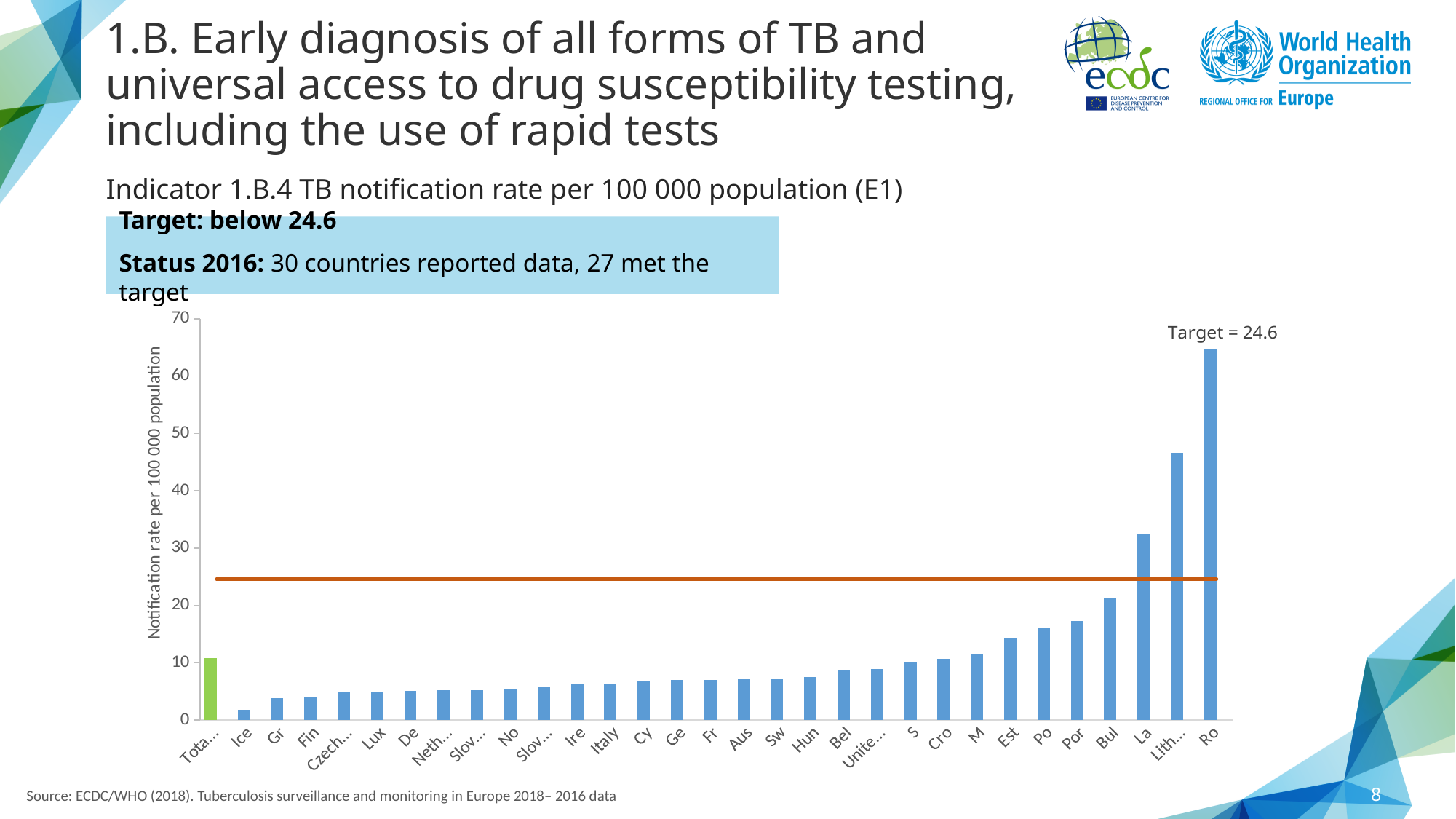
Is the value for La greater or less than 30? greater Which country has the lowest TB notification rate in the chart? Ice How many bars are plotted in the chart? 31 Which country has the highest TB notification rate in the chart? Ro Is the value for Ro greater or less than 60? greater Which has a higher notification rate, Ro or La? Ro Is the value for Lith... greater or less than 40? greater What is the label of the vertical axis? Notification rate per 100 000 population What is the target value marked by the horizontal line in the chart? 24.6 What kind of chart is shown on the slide? bar chart